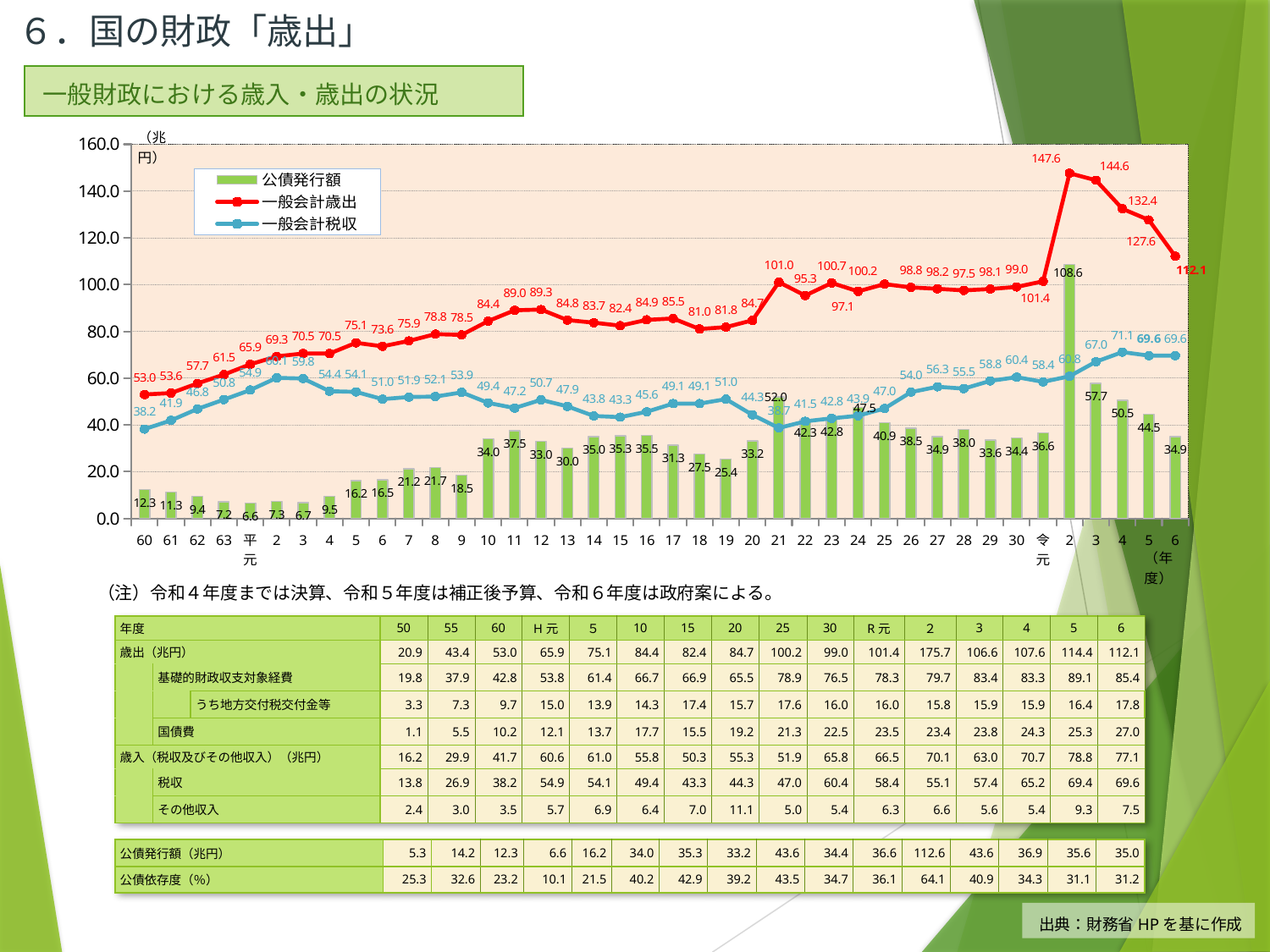
Is the value of 公債発行額 for 令和2 (令2) greater or less than 100? greater What is the value of 一般会計歳出 for 令和2 (令2)? 147.6 In which year does 一般会計歳出 reach its highest value? 令和2 (令2) How many series does the chart legend list? 3 What is the value of 公債発行額 for 平成元 (平元)? 6.6 What kind of chart is shown on the slide? Combined bar and line chart By how much did 公債発行額 fall from 令和2 (令2) to 令和3 (令3)? 50.9 Which is larger in 平成21 (21): 公債発行額 or 一般会計税収? 公債発行額 In which year is 公債発行額 at its lowest? 平成元 (平元) What is the value of 一般会計税収 for 令和4 (令4)? 71.1 What is the difference between 一般会計歳出 and 一般会計税収 in 令和2 (令2)? 86.8 Does 一般会計歳出 rise or fall from 令和2 (令2) to 令和6 (令6)? fall